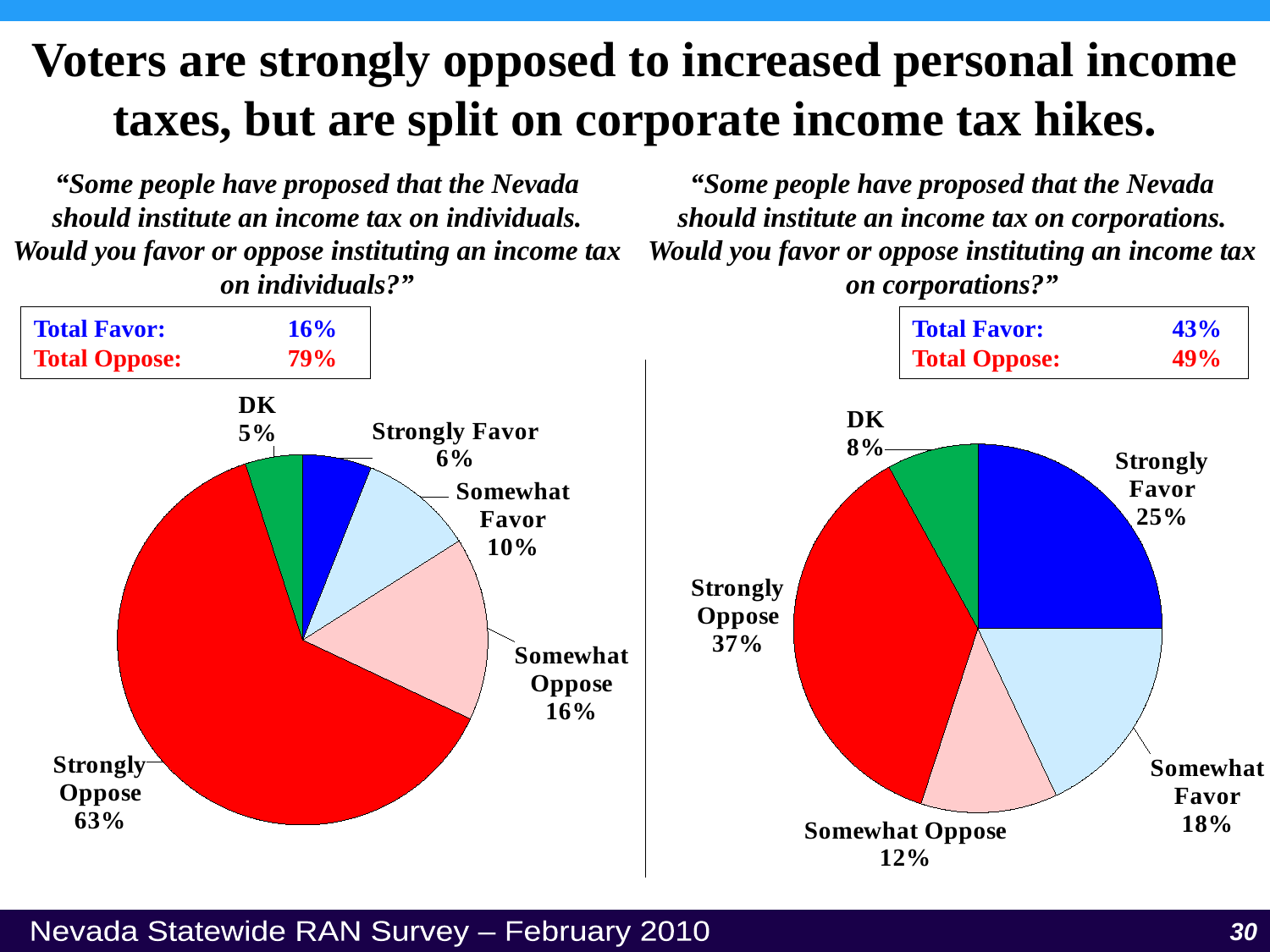
What type of chart is used on the right side of the slide (income tax on corporations)? Pie chart In the left pie chart (income tax on individuals), what is the difference between Somewhat Oppose and Somewhat Favor? 6% In the right pie chart (income tax on corporations), which category has the smallest slice? DK In the right pie chart (income tax on corporations), what is the difference between Strongly Oppose and Strongly Favor? 12% In the right pie chart (income tax on corporations), what is the DK share? 8% What colour is the Strongly Oppose slice in both pie charts? Red In the right pie chart (income tax on corporations), what share of respondents said Strongly Favor? 25% In the left pie chart (income tax on individuals), what is the combined share of Strongly Favor and Somewhat Favor? 16% In the left pie chart (income tax on individuals), which category has the largest slice? Strongly Oppose In the right pie chart (income tax on corporations), which is larger: Somewhat Favor or Somewhat Oppose? Somewhat Favor How many slices does the left pie chart (income tax on individuals) have? 5 In the left pie chart (income tax on individuals), what share of respondents said Strongly Oppose? 63%